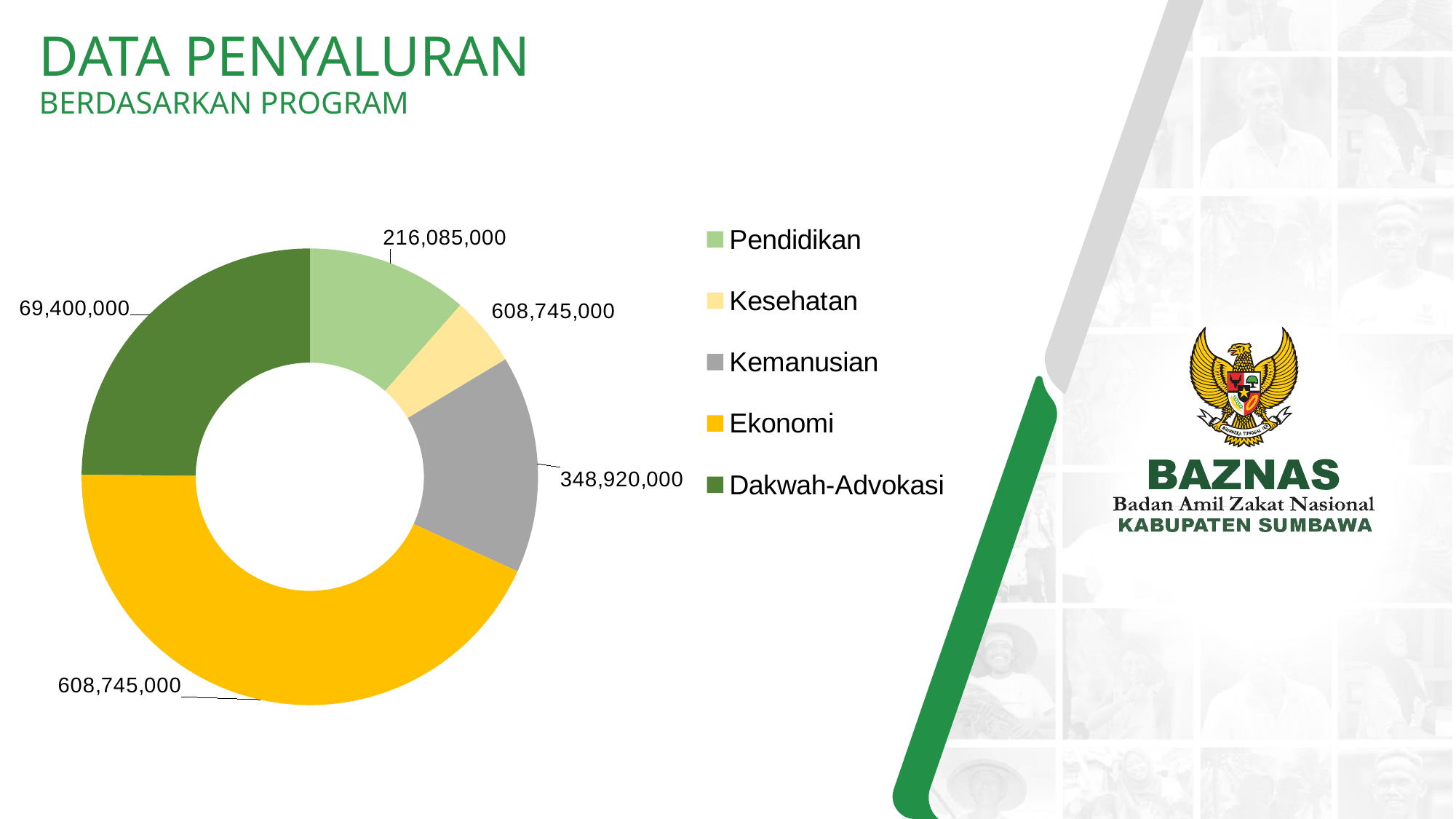
What is the title of the slide containing the chart? DATA PENYALURAN BERDASARKAN PROGRAM Which colour represents Ekonomi in the chart? Yellow What is the difference between the values for Kemanusian and Pendidikan? 132,835,000 What is the value shown for Ekonomi? 608,745,000 What type of chart is shown on the slide? Doughnut (pie) chart Which is larger, the value for Kemanusian or the value for Pendidikan? Kemanusian Which is larger, the value for Ekonomi or the value for Pendidikan? Ekonomi How many categories does the chart show? 5 How many entries does the legend list? 5 What is the value shown for Kemanusian? 348,920,000 What is the value shown for Pendidikan? 216,085,000 What is the value shown for Dakwah-Advokasi? 69,400,000